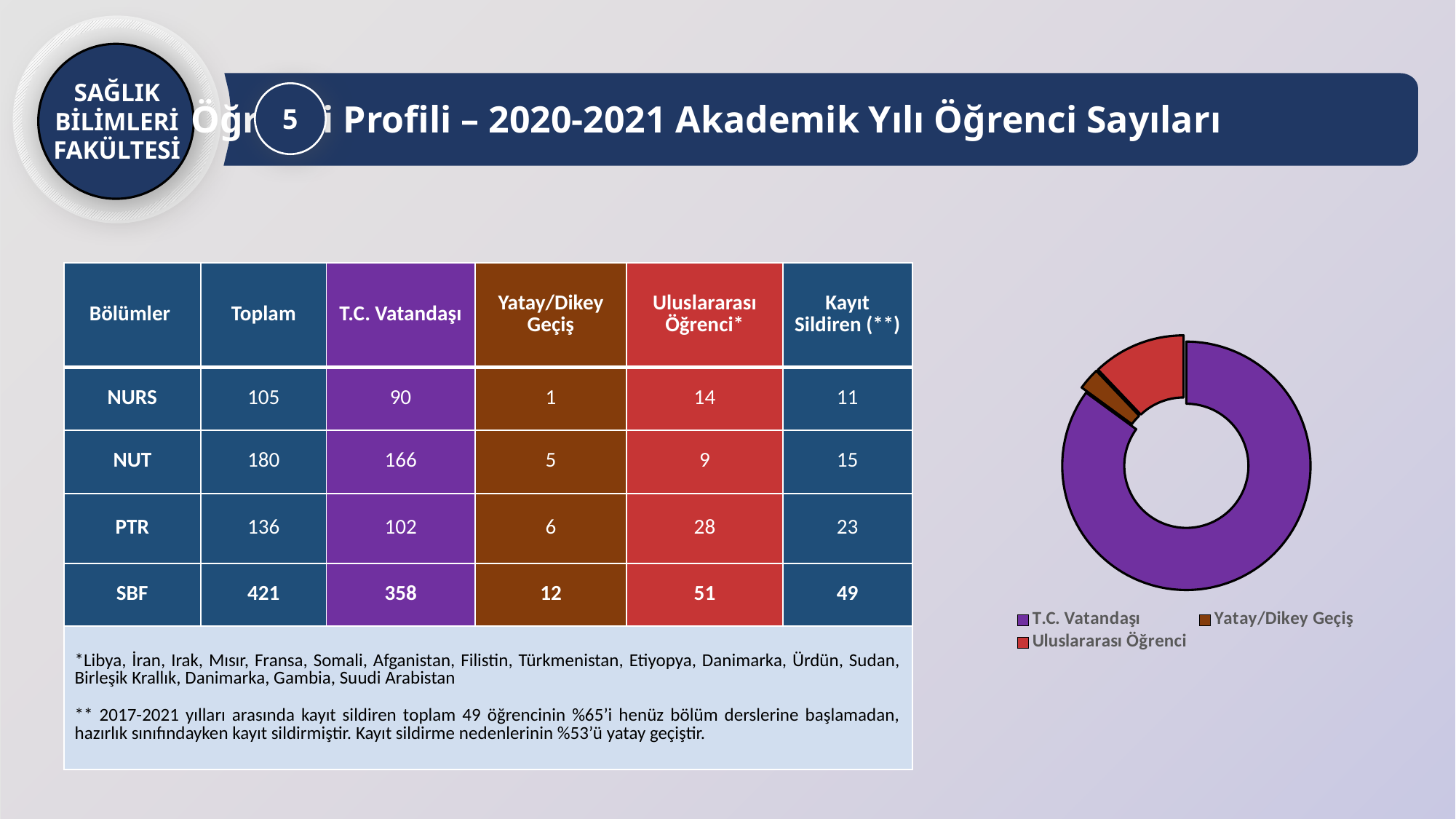
What colour is the T.C. Vatandaşı slice in the doughnut chart? purple How many entries does the legend of the doughnut chart list? 3 In the doughnut chart, which slice is larger: T.C. Vatandaşı or Uluslararası Öğrenci? T.C. Vatandaşı Which category has the largest slice in the doughnut chart? T.C. Vatandaşı In the doughnut chart, which slice is larger: Uluslararası Öğrenci or Yatay/Dikey Geçiş? Uluslararası Öğrenci How many slices does the doughnut chart have? 3 What kind of chart is shown on the right side of the slide? doughnut chart Which category has the smallest slice in the doughnut chart? Yatay/Dikey Geçiş Which legend entry of the doughnut chart is shown in red? Uluslararası Öğrenci